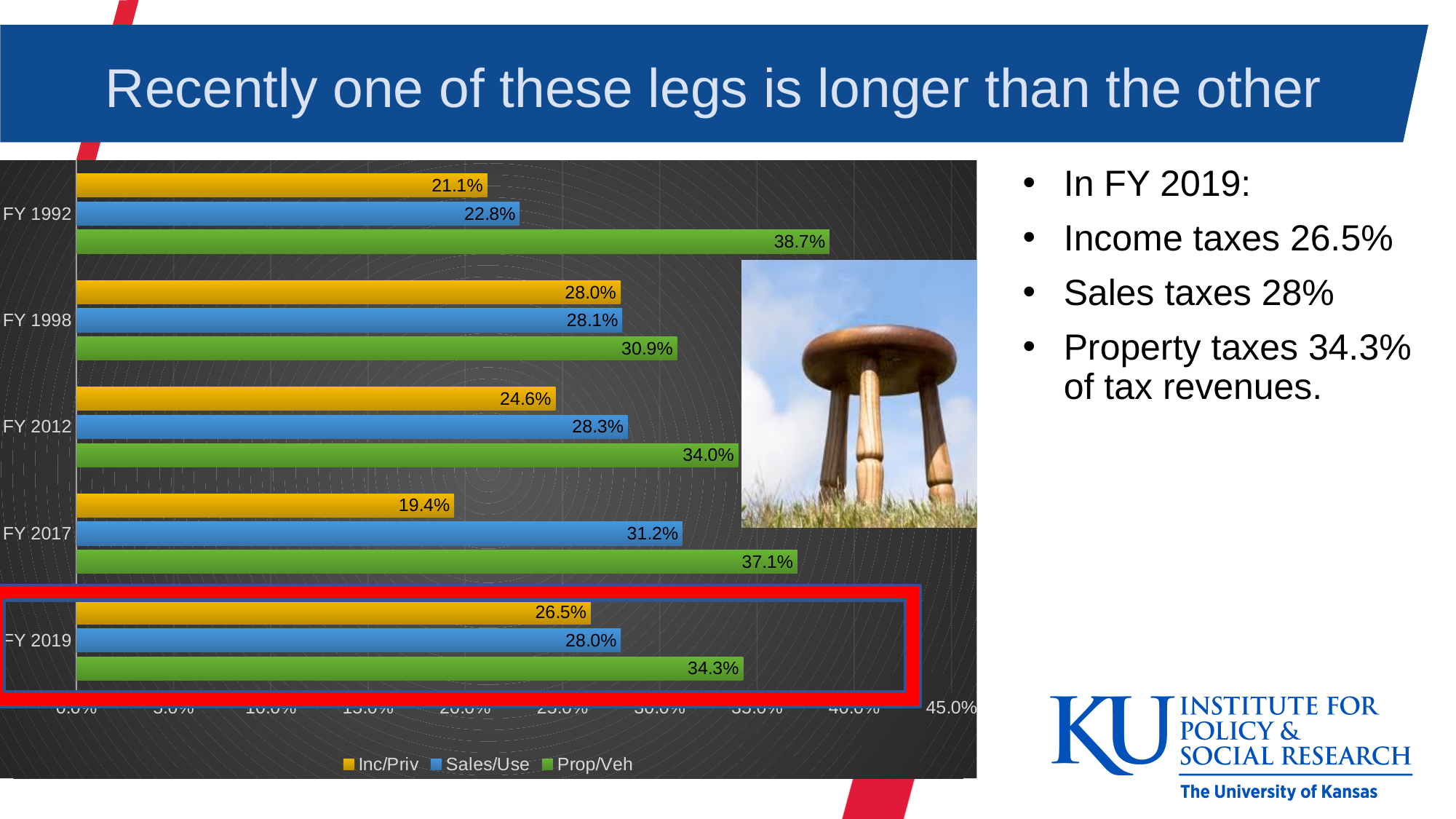
What is the Sales/Use value for FY 2012? 28.3% What is the difference between the Prop/Veh and Inc/Priv values for FY 2019? 7.8% In which fiscal year is the Inc/Priv value lowest? FY 2017 In which fiscal year is the Prop/Veh value highest? FY 1992 Which is larger for FY 1998, the Inc/Priv value or the Sales/Use value? Sales/Use What is the Inc/Priv value for FY 2017? 19.4% What is the Prop/Veh value for FY 1992? 38.7% How many series does the legend list? 3 How many fiscal years are shown on the chart? 5 Is the Sales/Use value for FY 2017 greater or less than 30.0%? greater Which series is shown in green in the legend? Prop/Veh What kind of chart is shown on the slide? bar chart